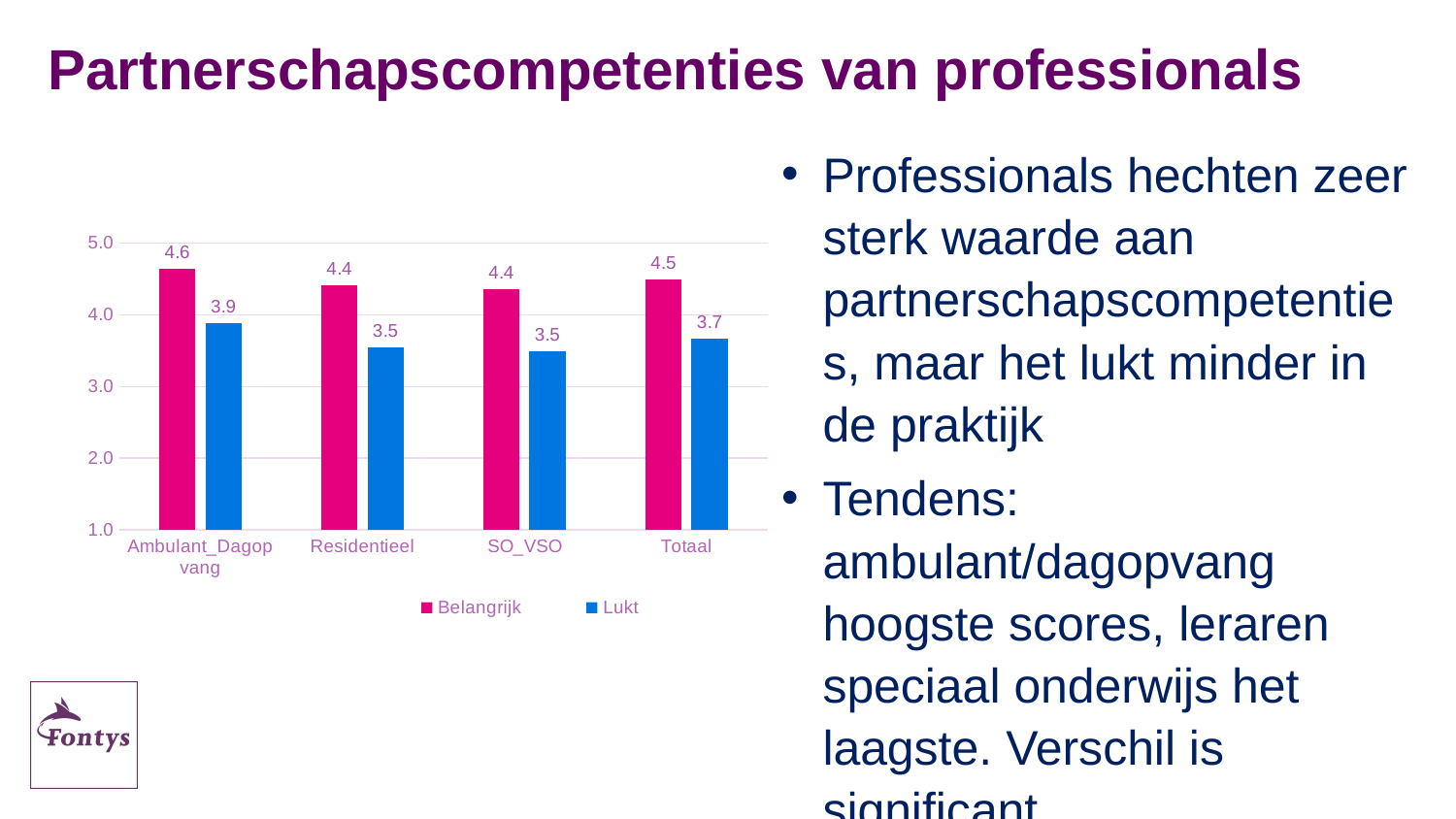
What is the Lukt value for Residentieel? 3.5 What is the Belangrijk value for Totaal? 4.5 What is the difference between the Belangrijk and Lukt values for Totaal? 0.8 How many categories are shown on the x axis? 4 What is the difference between the Belangrijk and Lukt values for Ambulant_Dagopvang? 0.7 Which category has the highest Lukt value? Ambulant_Dagopvang What kind of chart is shown on the slide? Bar chart Which is larger for Residentieel, the Belangrijk value or the Lukt value? Belangrijk What is the Lukt value for SO_VSO? 3.5 How many series does the legend list? 2 What is the Belangrijk value for Ambulant_Dagopvang? 4.6 Which category has the highest Belangrijk value? Ambulant_Dagopvang